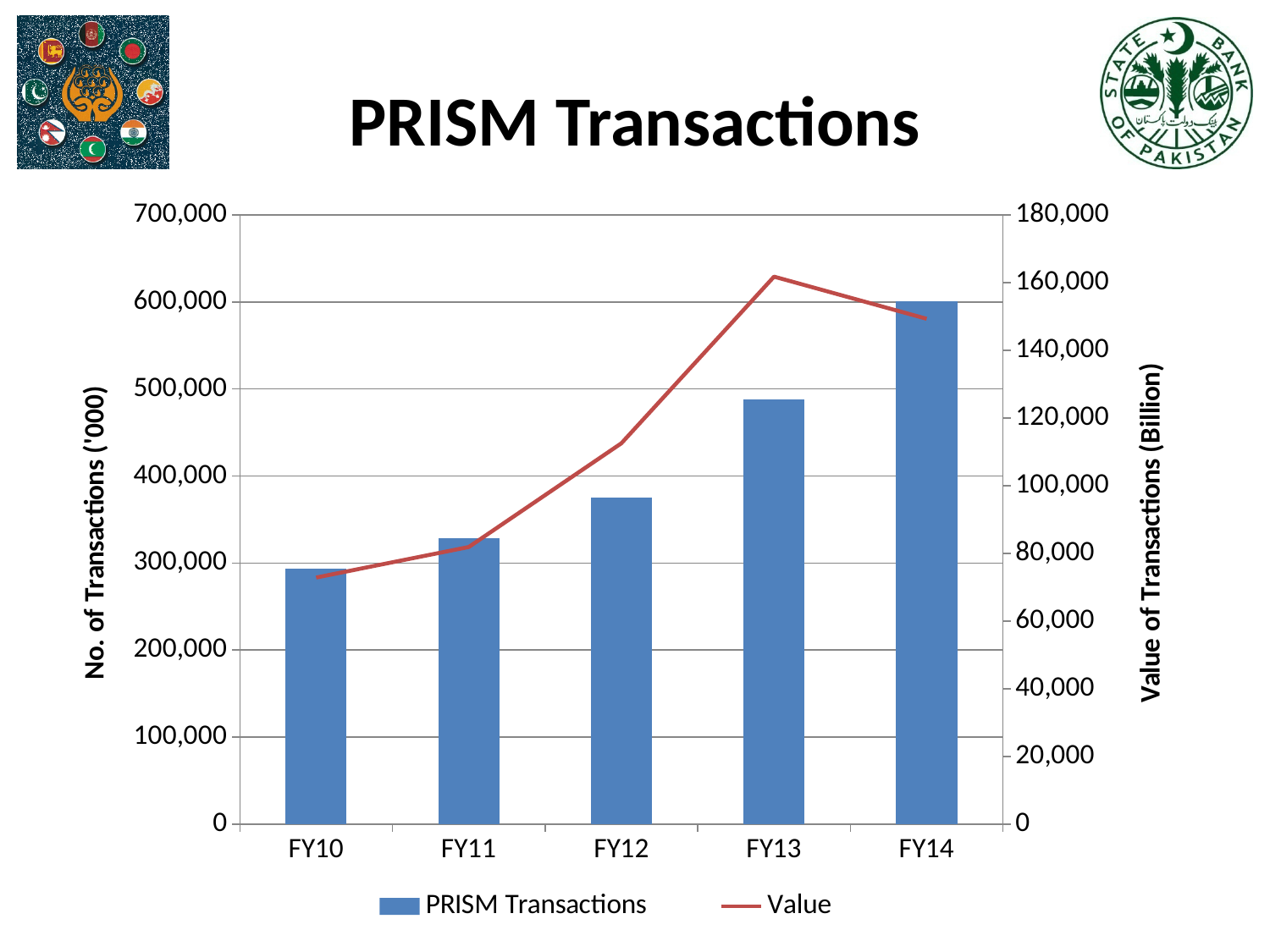
Is the value of transactions for FY10 greater or less than 80,000? less Which fiscal year has the lowest number of PRISM transactions? FY10 What is the label of the right-hand vertical axis? Value of Transactions (Billion) Which is larger, the value of transactions in FY13 or in FY14? FY13 How many series does the legend list? 2 Which fiscal year has the highest number of PRISM transactions? FY14 Do the PRISM Transactions bars rise or fall from FY10 to FY14? Rise Which fiscal year has the highest value of transactions according to the Value line? FY13 How many fiscal years are shown on the x axis? 5 What kind of chart is shown on the slide? A combined bar and line chart Is the number of PRISM transactions for FY13 greater or less than 400,000? greater What is the title of the chart? PRISM Transactions